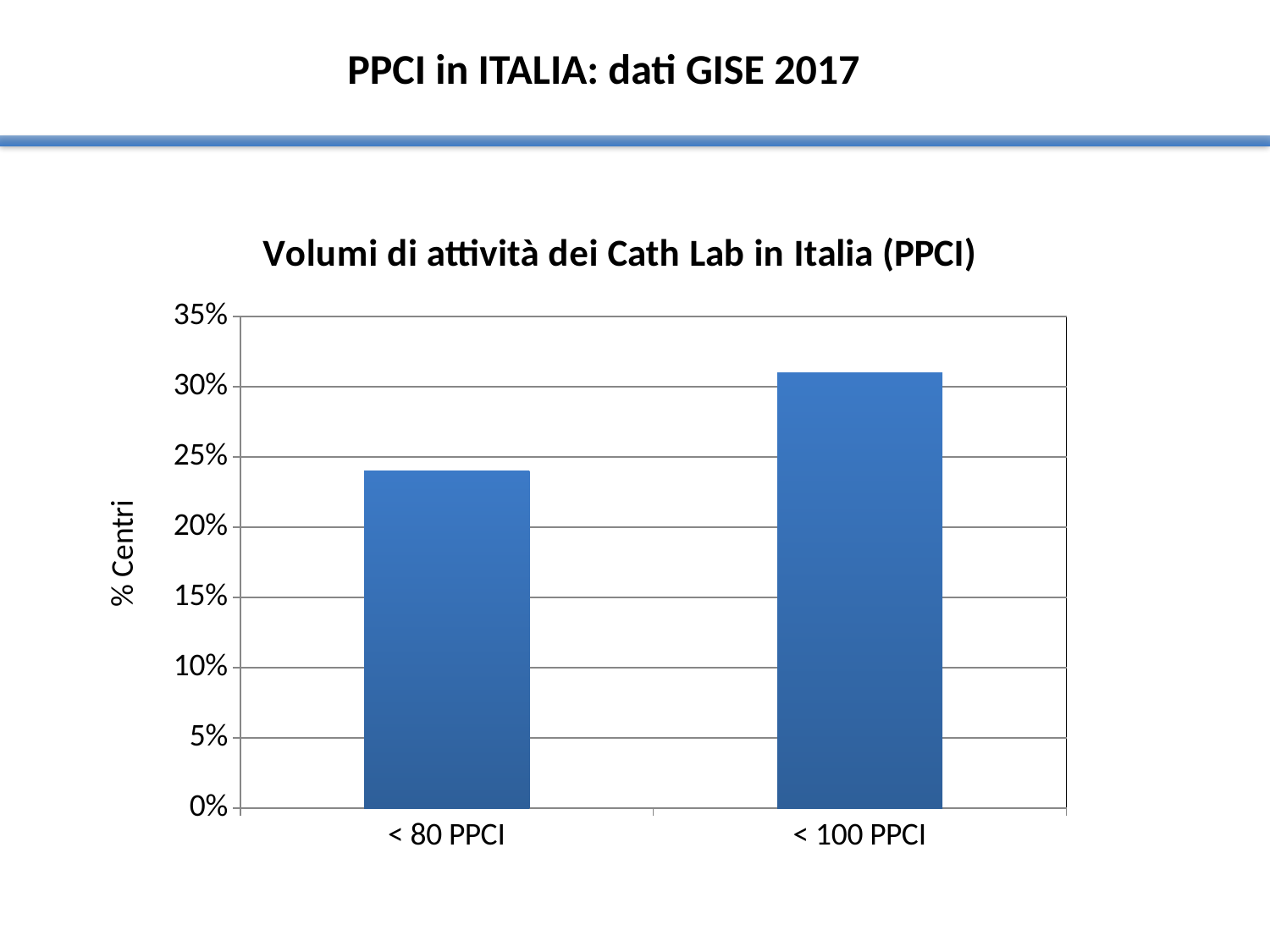
How many categories are shown on the x axis of the chart? 2 What type of chart is shown on the slide? bar chart Is the value for < 80 PPCI greater or less than 20%? greater What is the title of the chart? Volumi di attività dei Cath Lab in Italia (PPCI) Which is larger, the value for < 80 PPCI or the value for < 100 PPCI? < 100 PPCI Which category has the highest value? < 100 PPCI Is the value for < 100 PPCI greater or less than 30%? greater Is the value for < 80 PPCI greater or less than 25%? less What is the label on the vertical axis of the chart? % Centri Which category has the lowest value? < 80 PPCI Do the values rise or fall from left to right along the x axis? rise